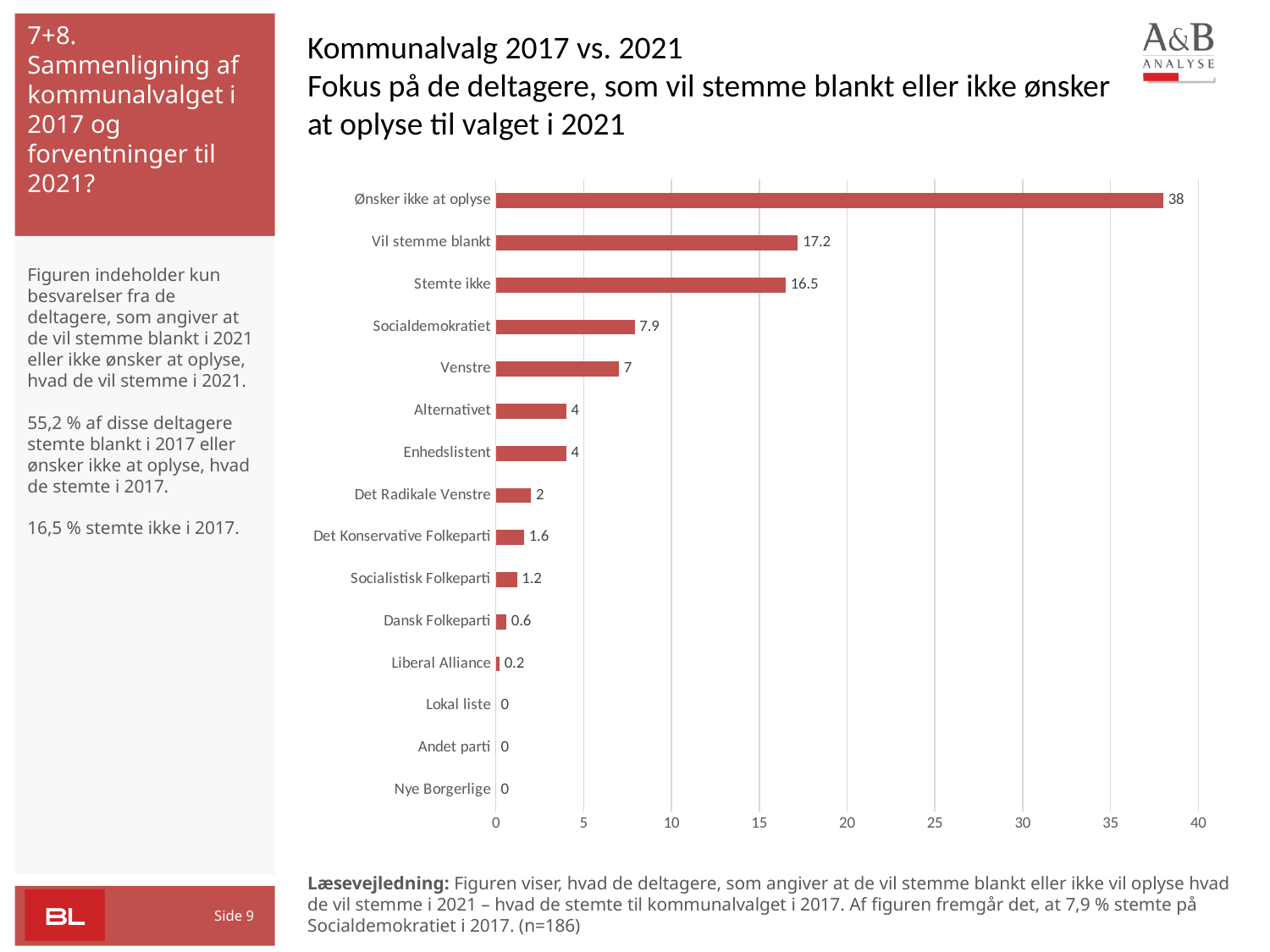
How many categories are shown on the chart? 15 What is the value for Socialdemokratiet? 7.9 Is the value for Stemte ikke greater or less than 15? greater How many categories have a value of 0? 3 Which is larger, the value for Venstre or the value for Alternativet? Venstre What is the difference between the values for Vil stemme blankt and Stemte ikke? 0.7 Which category has the highest value? Ønsker ikke at oplyse What is the value for Liberal Alliance? 0.2 What is the value for Det Konservative Folkeparti? 1.6 What is the value for Ønsker ikke at oplyse? 38 What is the highest value shown on the horizontal axis? 40 What kind of chart is shown on the slide? Bar chart